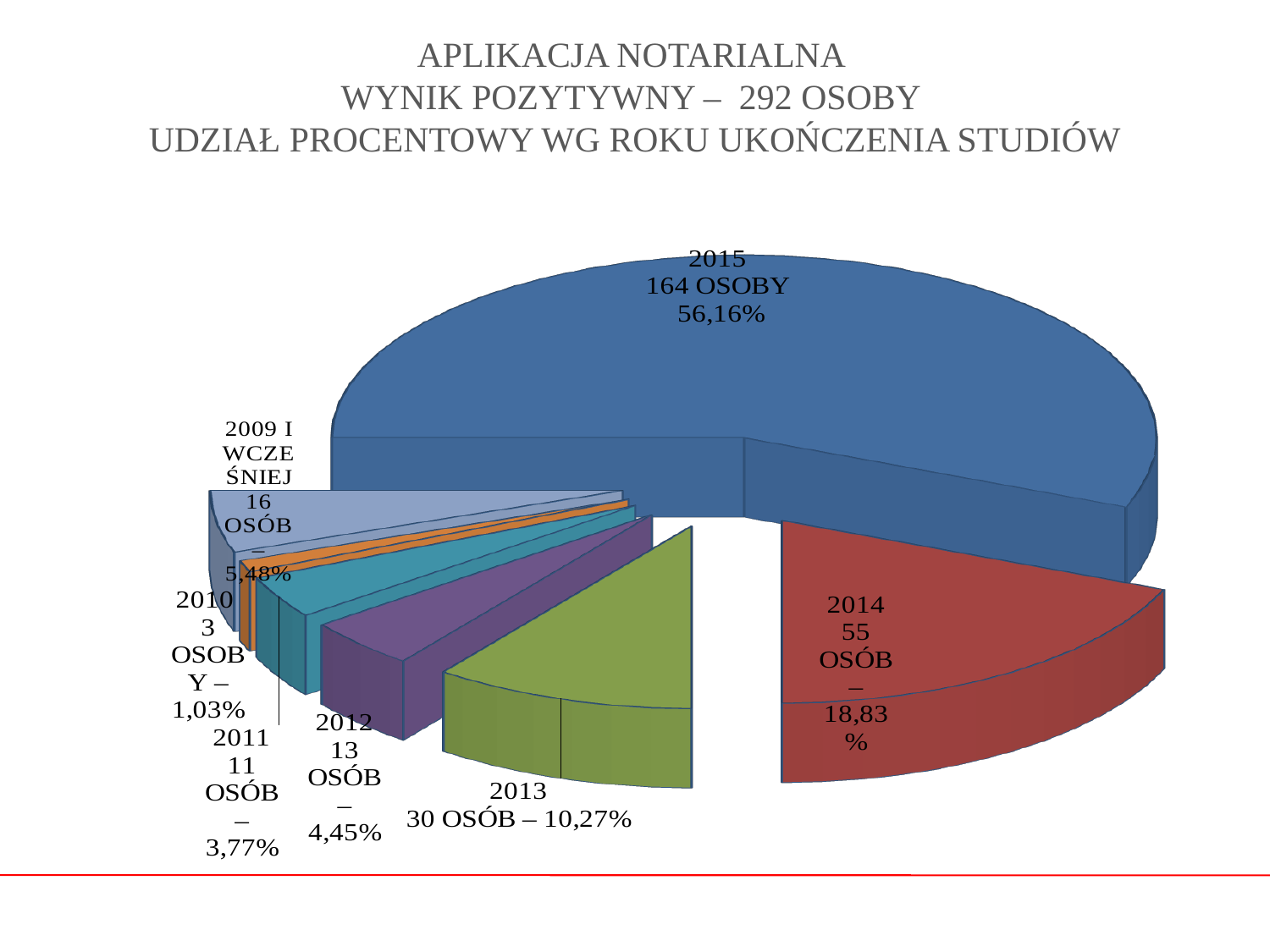
What kind of chart is shown on the slide? pie chart Which has more people, 2013 or 2009 I WCZEŚNIEJ? 2013 What percentage share does the 2013 slice have? 10,27% Which year has the smallest slice of the pie? 2010 How many people are shown for 2012? 13 OSÓB How many people are shown for 2015? 164 OSOBY What percentage share does the '2009 I WCZEŚNIEJ' slice have? 5,48% Which year has the largest slice of the pie? 2015 What percentage share does the 2014 slice have? 18,83% How many slices does the pie chart have? 7 What is the difference in number of people between 2015 and 2014? 109